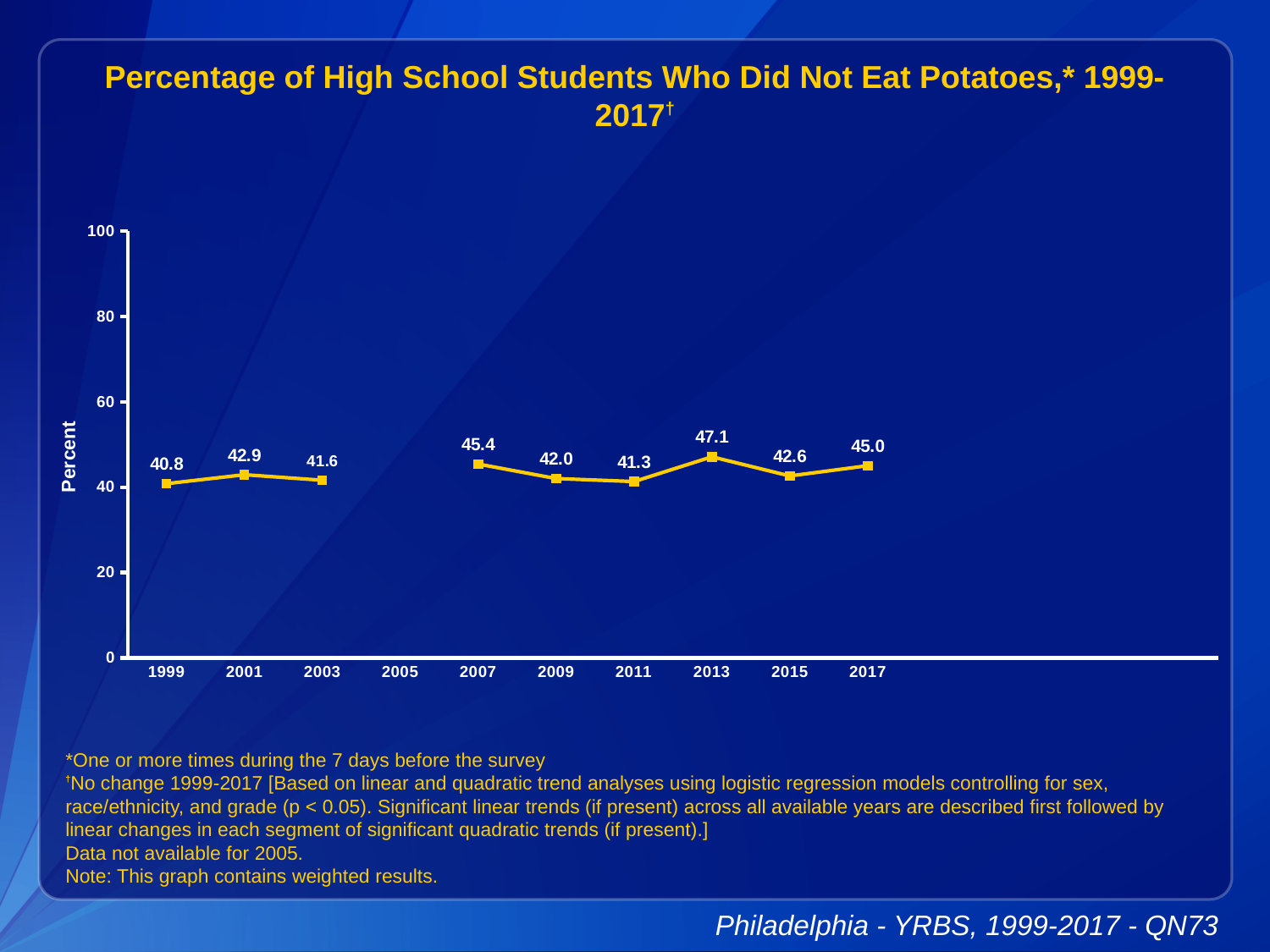
Which year has the lowest percentage of students who did not eat potatoes? 1999 Which year on the x axis has no data point plotted? 2005 How many years have data points plotted on the chart? 9 What is the label on the y axis? Percent Which year has a larger value, 2007 or 2009? 2007 What percentage of high school students did not eat potatoes in 1999? 40.8 What is the value plotted for 2013? 47.1 Is the value for 2015 greater or less than 60? less Which year has the highest percentage of students who did not eat potatoes? 2013 What is the difference between the values for 2013 and 2011? 5.8 What kind of chart is shown on the slide? line chart What is the value plotted for 2017? 45.0